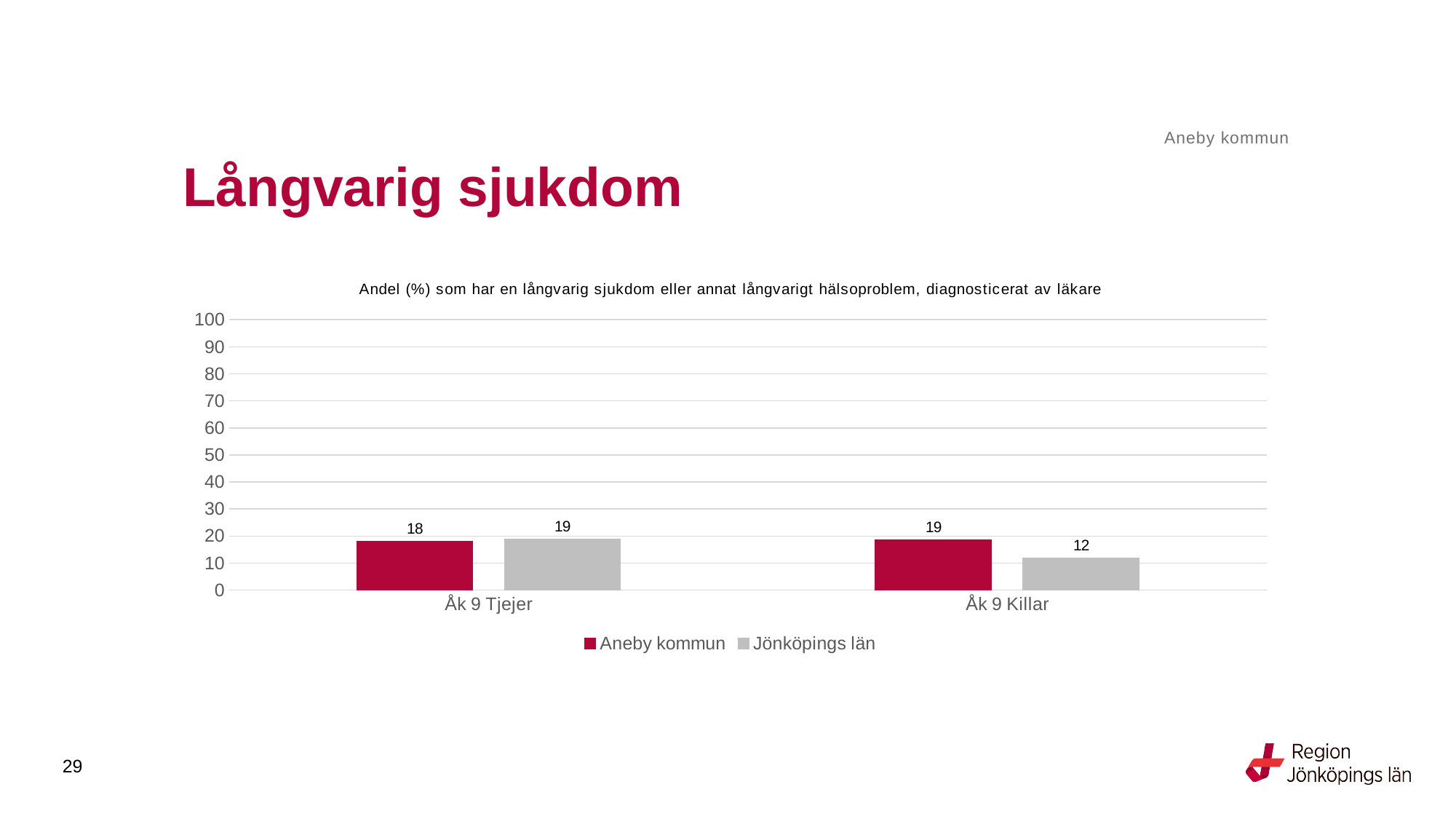
Which category has the lowest value for Jönköpings län? Åk 9 Killar What kind of chart is shown on the slide? bar chart What is the value for Aneby kommun in the Åk 9 Killar category? 19 What is the value for Aneby kommun in the Åk 9 Tjejer category? 18 What is the difference between Aneby kommun and Jönköpings län in the Åk 9 Killar category? 7 What is the difference between Aneby kommun and Jönköpings län in the Åk 9 Tjejer category? 1 How many categories are shown on the x axis? 2 What is the value for Jönköpings län in the Åk 9 Killar category? 12 In the Åk 9 Killar category, which series has the larger value, Aneby kommun or Jönköpings län? Aneby kommun What is the value for Jönköpings län in the Åk 9 Tjejer category? 19 Is the value for Jönköpings län in Åk 9 Killar greater or less than 20? less How many series does the legend list? 2